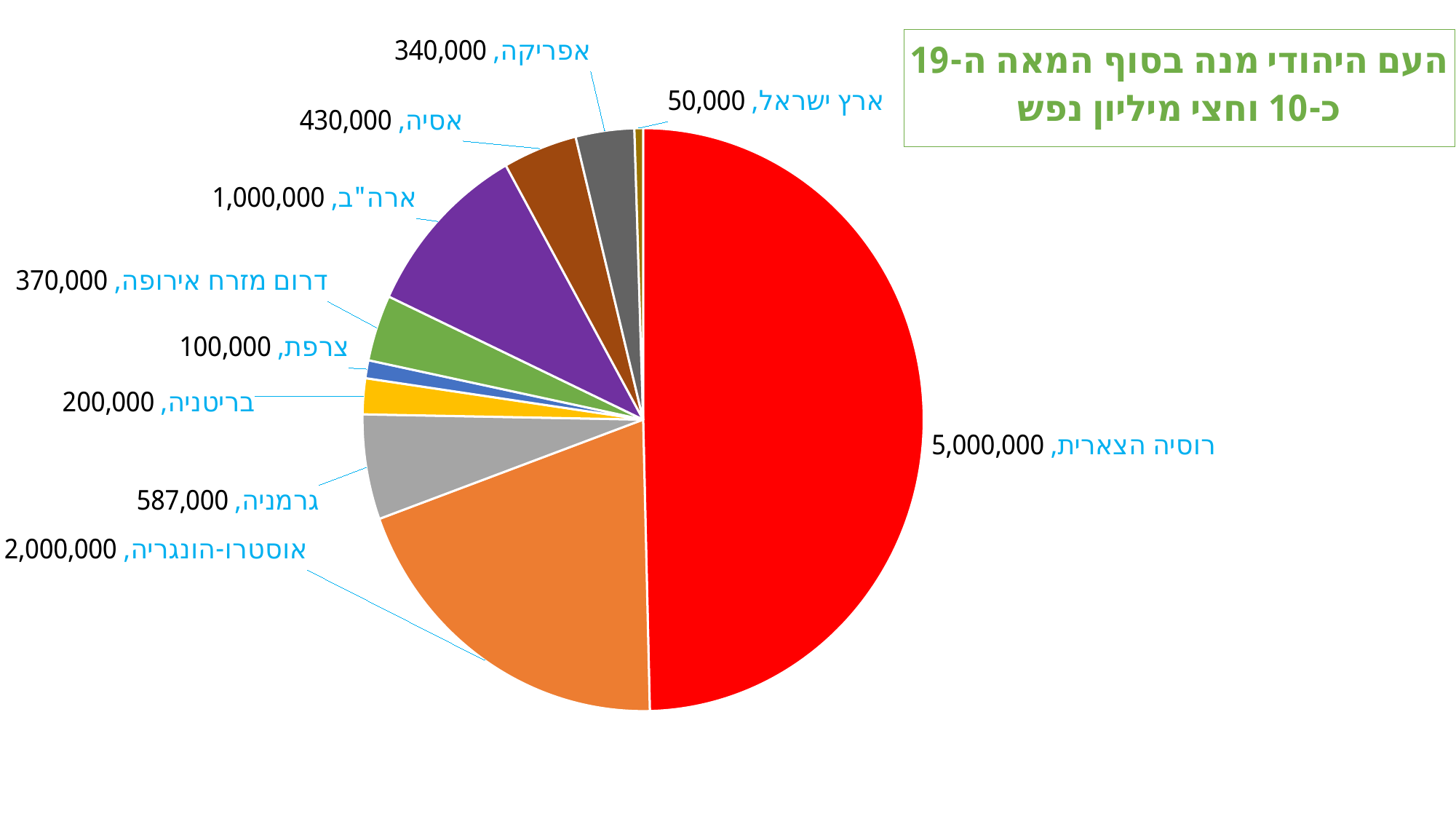
What type of chart is shown on the slide? pie chart What is the difference between the values for אסיה and אפריקה? 90,000 What is the difference between the values for רוסיה הצארית and אוסטרו-הונגריה? 3,000,000 Which is larger, the value for ארה"ב or the value for גרמניה? ארה"ב How many slices does the pie chart have? 10 What is the value for רוסיה הצארית? 5,000,000 Which category has the smallest slice? ארץ ישראל What is the title text shown in the green box on the slide? העם היהודי מנה בסוף המאה ה-19 כ-10 וחצי מיליון נפש Which category has the largest slice? רוסיה הצארית What is the value for גרמניה? 587,000 What is the value for אוסטרו-הונגריה? 2,000,000 What is the value for ארץ ישראל? 50,000